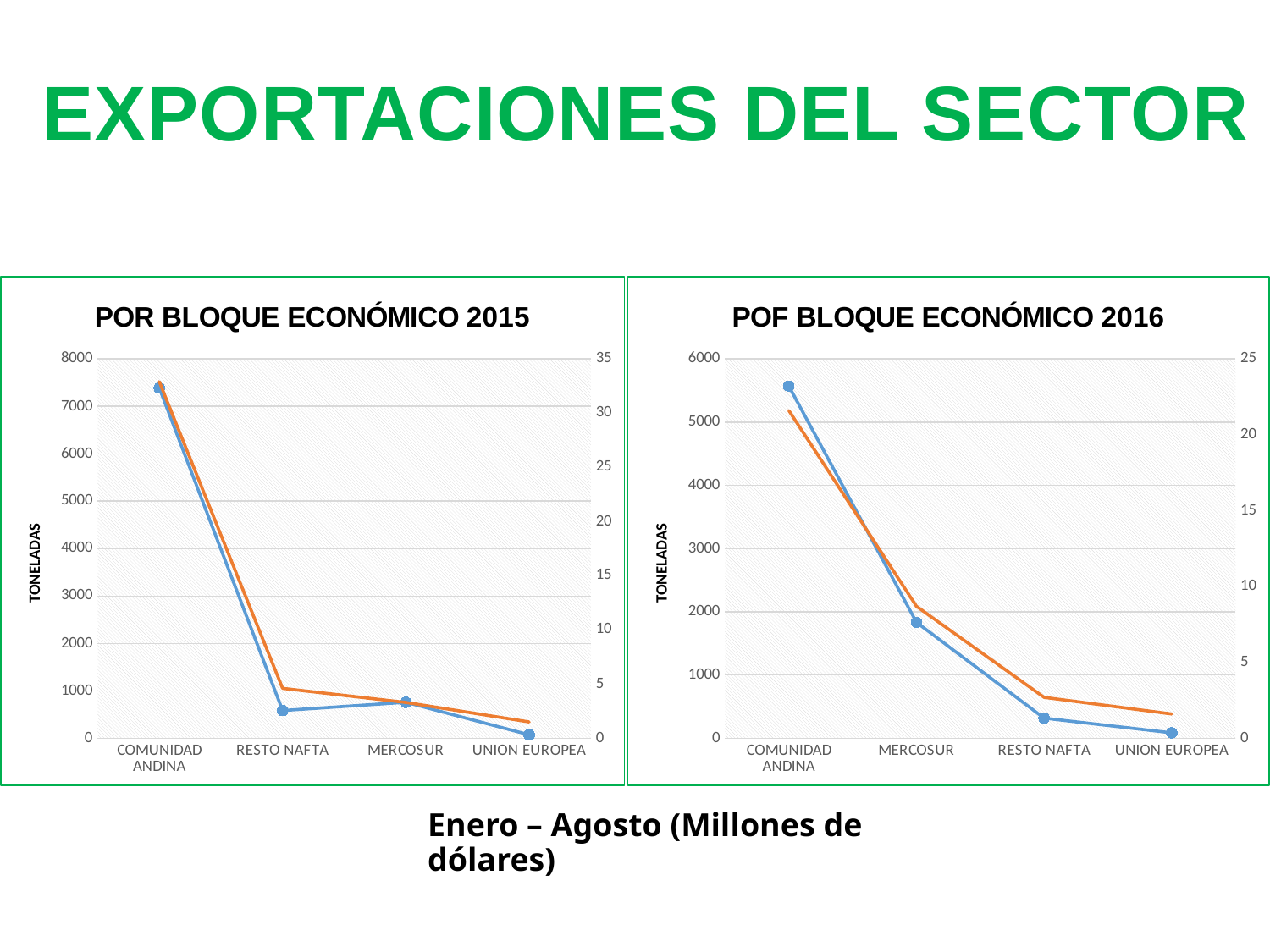
In the 'POF BLOQUE ECONÓMICO 2016' chart, do the toneladas values (blue line) rise or fall from COMUNIDAD ANDINA to UNION EUROPEA? fall In the 'POR BLOQUE ECONÓMICO 2015' chart, is the toneladas value (blue line) for COMUNIDAD ANDINA greater or less than 7000? greater In the 'POF BLOQUE ECONÓMICO 2016' chart, is the toneladas value (blue line) for COMUNIDAD ANDINA greater or less than 5000? greater In the 'POF BLOQUE ECONÓMICO 2016' chart, is the toneladas value (blue line) for MERCOSUR greater or less than 2000? less In the 'POF BLOQUE ECONÓMICO 2016' chart, which economic bloc has the lowest value in toneladas (blue line)? UNION EUROPEA In the 'POR BLOQUE ECONÓMICO 2015' chart, which economic bloc has the highest value in toneladas (blue line)? COMUNIDAD ANDINA In the 'POF BLOQUE ECONÓMICO 2016' chart, which has the larger toneladas value (blue line): MERCOSUR or RESTO NAFTA? MERCOSUR In the 'POF BLOQUE ECONÓMICO 2016' chart, which economic bloc has the highest value in toneladas (blue line)? COMUNIDAD ANDINA What is the label of the left vertical axis on the 'POR BLOQUE ECONÓMICO 2015' chart? TONELADAS How many economic blocs are shown on the x axis of the 'POF BLOQUE ECONÓMICO 2016' chart? 4 What kind of chart is the 'POR BLOQUE ECONÓMICO 2015' chart? line chart In the 'POR BLOQUE ECONÓMICO 2015' chart, which economic bloc has the lowest value in toneladas (blue line)? UNION EUROPEA